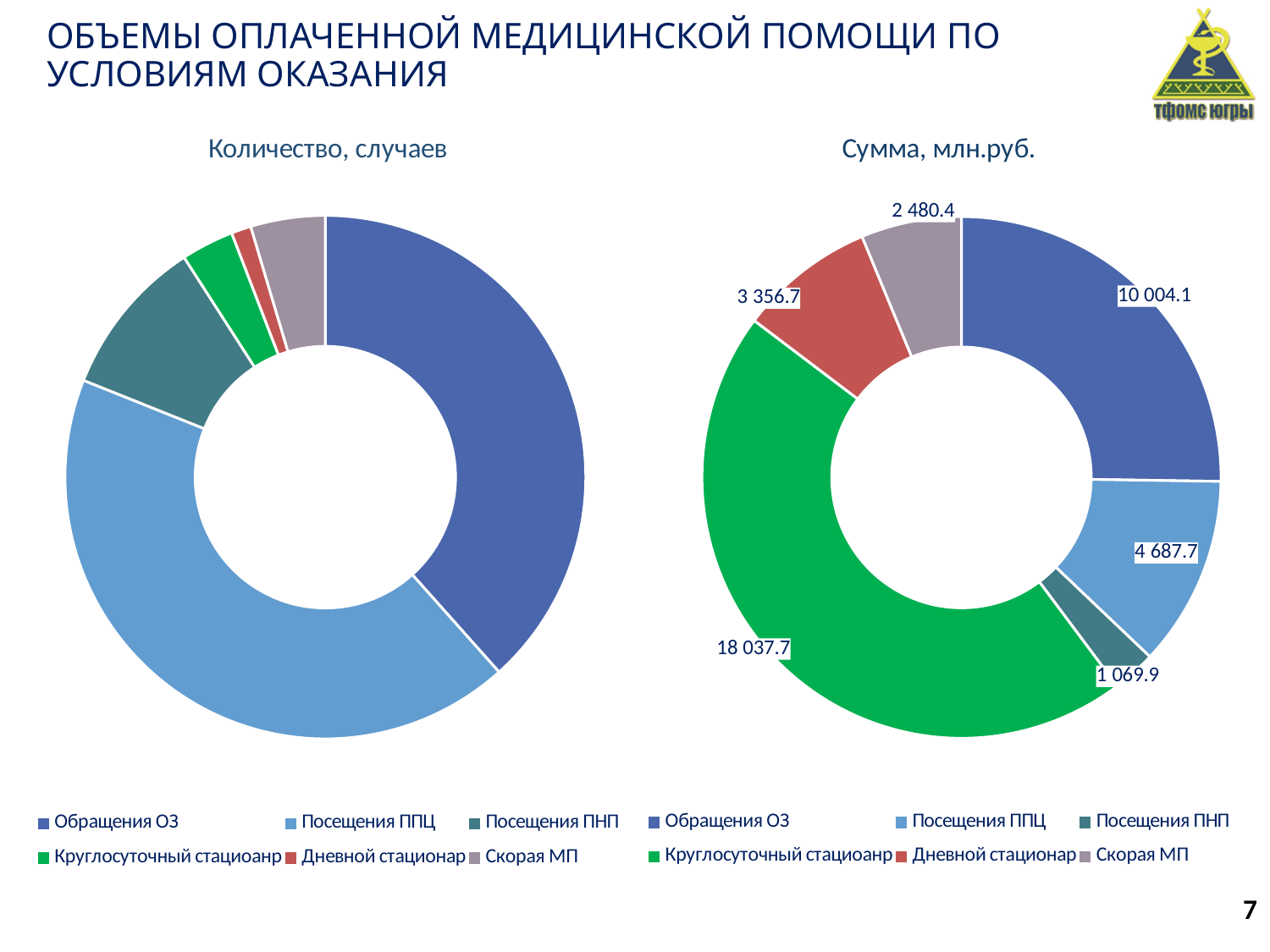
How many categories does the 'Количество, случаев' chart show? 6 In the 'Сумма, млн.руб.' chart, which category has the highest value? Круглосуточный стациоанр In the 'Сумма, млн.руб.' chart, what is the value for Скорая МП? 2 480.4 In the 'Сумма, млн.руб.' chart, what is the value for Посещения ПНП? 1 069.9 In the 'Сумма, млн.руб.' chart, which category has the lowest value? Посещения ПНП In the 'Сумма, млн.руб.' chart, what is the value for Круглосуточный стациоанр? 18 037.7 In the 'Сумма, млн.руб.' chart, what is the value for Обращения ОЗ? 10 004.1 In the 'Количество, случаев' chart, which slice is larger: Посещения ПНП or Круглосуточный стациоанр? Посещения ПНП In the 'Сумма, млн.руб.' chart, which is larger: Посещения ППЦ or Дневной стационар? Посещения ППЦ In the 'Количество, случаев' chart, which category has the smallest slice? Дневной стационар In the 'Сумма, млн.руб.' chart, what is the difference between Круглосуточный стациоанр and Обращения ОЗ? 8 033.6 In the 'Сумма, млн.руб.' chart, what is the difference between Дневной стационар and Скорая МП? 876.3